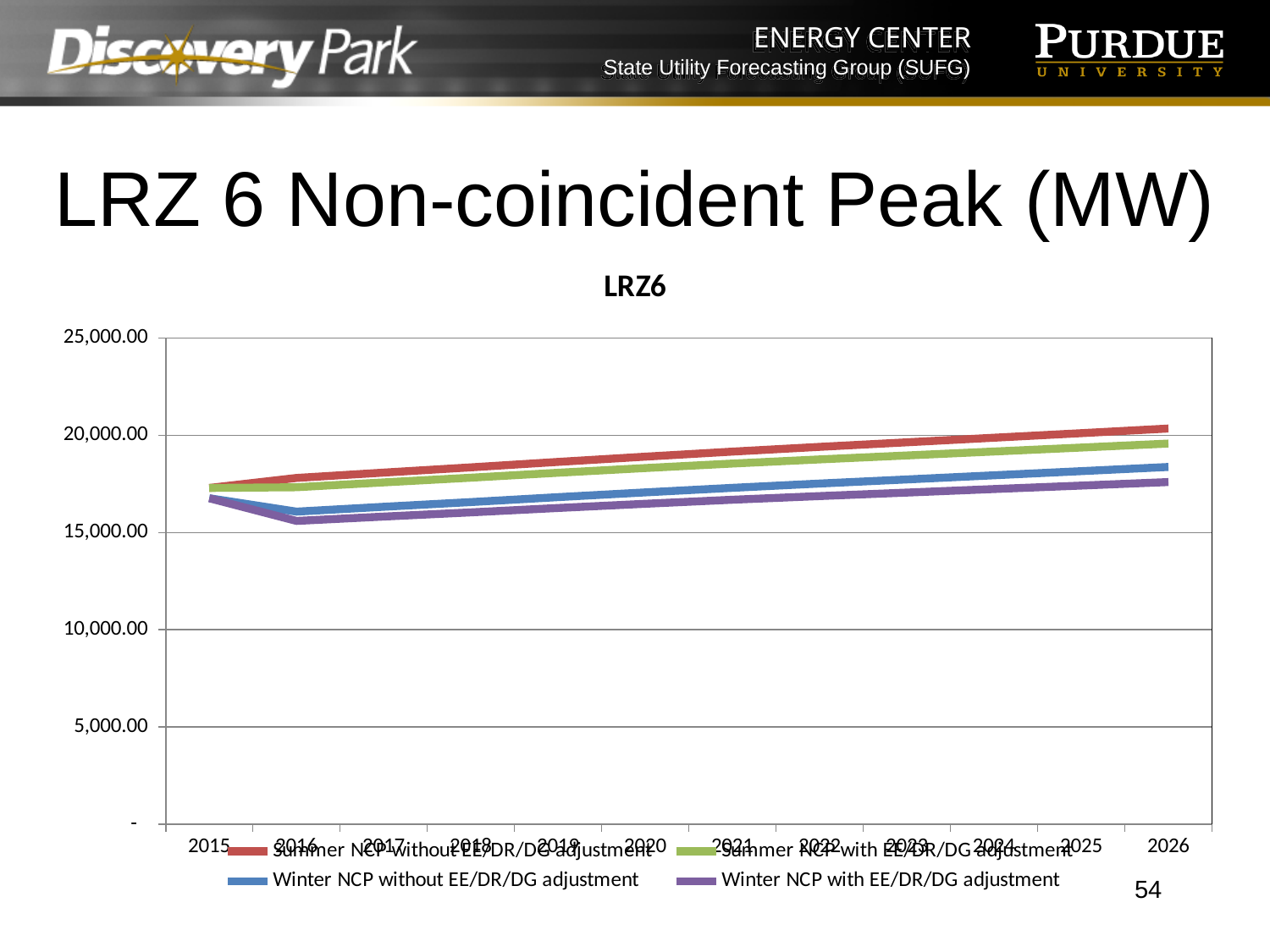
Does the Summer NCP without EE/DR/DG adjustment series rise or fall from 2015 to 2026? Rise What kind of chart is shown on the slide? Line chart Is the value for Winter NCP with EE/DR/DG adjustment in 2016 greater or less than 20,000.00? less In 2026, which is larger: Summer NCP without EE/DR/DG adjustment or Winter NCP with EE/DR/DG adjustment? Summer NCP without EE/DR/DG adjustment What is the title shown above the chart plot area? LRZ6 Which series has the highest value in 2026? Summer NCP without EE/DR/DG adjustment Which series has the lowest value in 2026? Winter NCP with EE/DR/DG adjustment Which series is drawn in red in the chart? Summer NCP without EE/DR/DG adjustment Is the value for Summer NCP without EE/DR/DG adjustment in 2015 greater or less than 15,000.00? greater How many series does the chart legend list? 4 How many years are shown along the x axis of the chart? 12 Does the Winter NCP with EE/DR/DG adjustment series rise or fall from 2016 to 2026? Rise